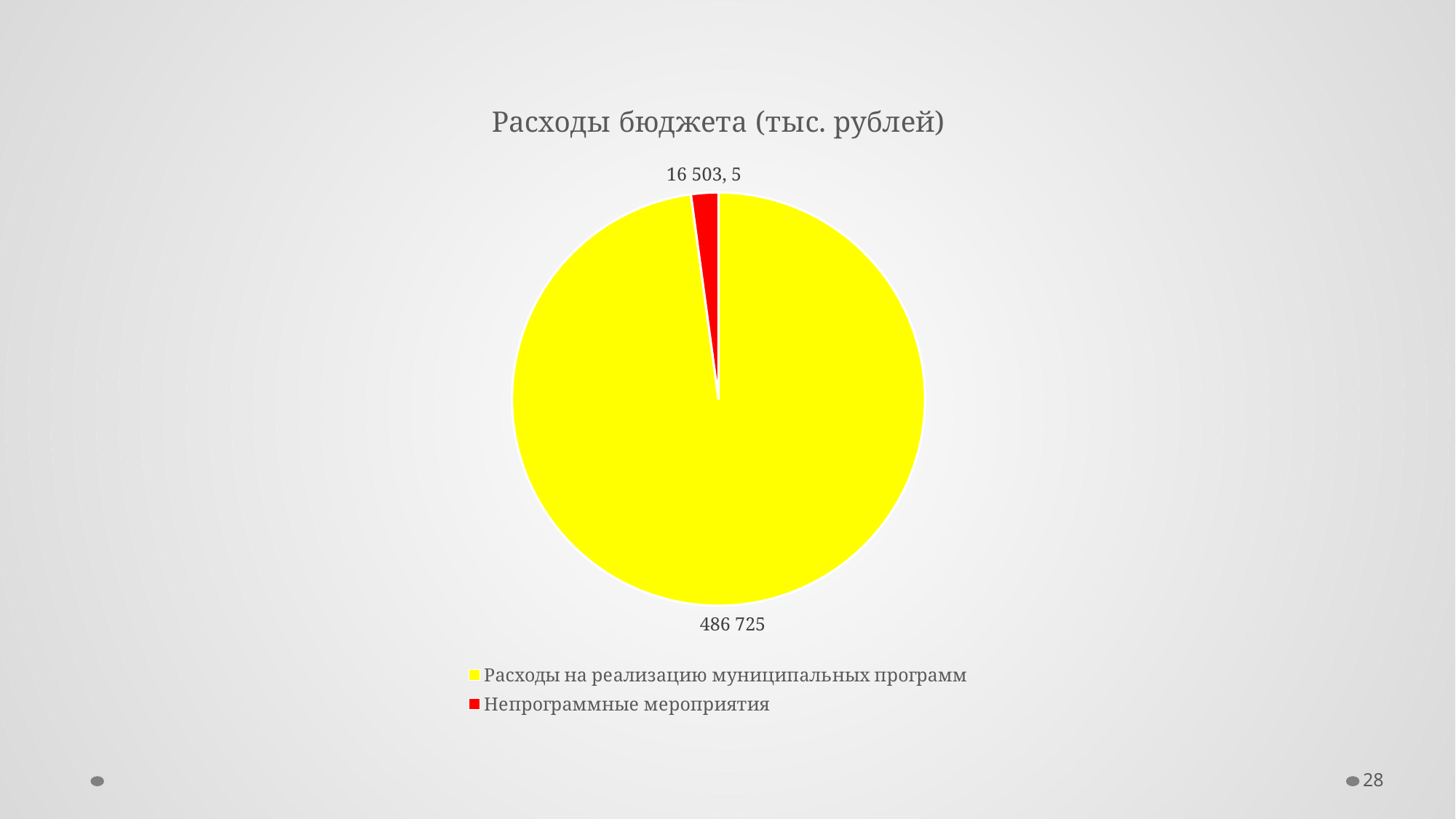
What type of chart is shown on the slide? Pie chart What is the value for Непрограммные мероприятия? 16 503, 5 How many entries does the legend list? 2 What is the value for Расходы на реализацию муниципальных программ? 486 725 What is the difference between the value for Расходы на реализацию муниципальных программ and the value for Непрограммные мероприятия? 470 221,5 Which category has the smallest slice of the pie? Непрограммные мероприятия Which is larger: Расходы на реализацию муниципальных программ or Непрограммные мероприятия? Расходы на реализацию муниципальных программ How many slices does the pie chart have? 2 What colour is the slice for Непрограммные мероприятия? Red Which category has the largest slice of the pie? Расходы на реализацию муниципальных программ What is the total of the two values shown on the pie chart? 503 228,5 What is the title of the chart? Расходы бюджета (тыс. рублей)